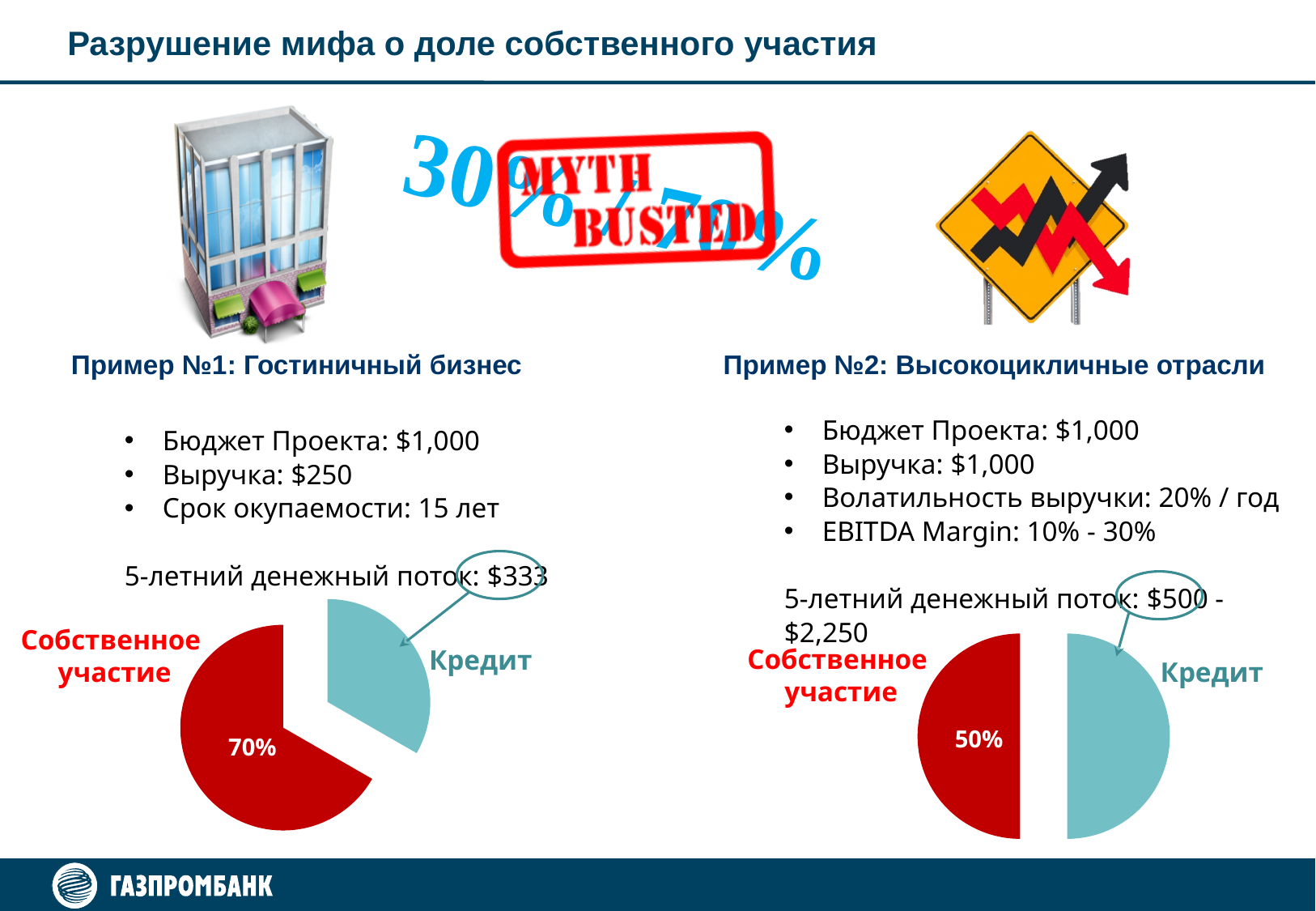
How many slices does the left pie chart (Пример №1) have? 2 In the left pie chart (Пример №1), which slice is larger, "Собственное участие" or "Кредит"? Собственное участие In the right pie chart (Пример №2), what colour is the "Собственное участие" slice? Red Is the "Собственное участие" share in the left pie chart (Пример №1) greater or less than 50%? greater In the right pie chart (Пример №2), what share is labelled for "Собственное участие"? 50% In the left pie chart (Пример №1), which slice is the smallest? Кредит In the left pie chart (Пример №1), what share is labelled for "Собственное участие"? 70% In the left pie chart (Пример №1), which slice is the largest? Собственное участие What kind of chart is shown under "Пример №2: Высокоцикличные отрасли" on the right of the slide? Pie chart In the left pie chart (Пример №1), what colour is the "Кредит" slice? Teal (light blue) What kind of chart is shown under "Пример №1: Гостиничный бизнес" on the left of the slide? Pie chart How many slices does the right pie chart (Пример №2) have? 2